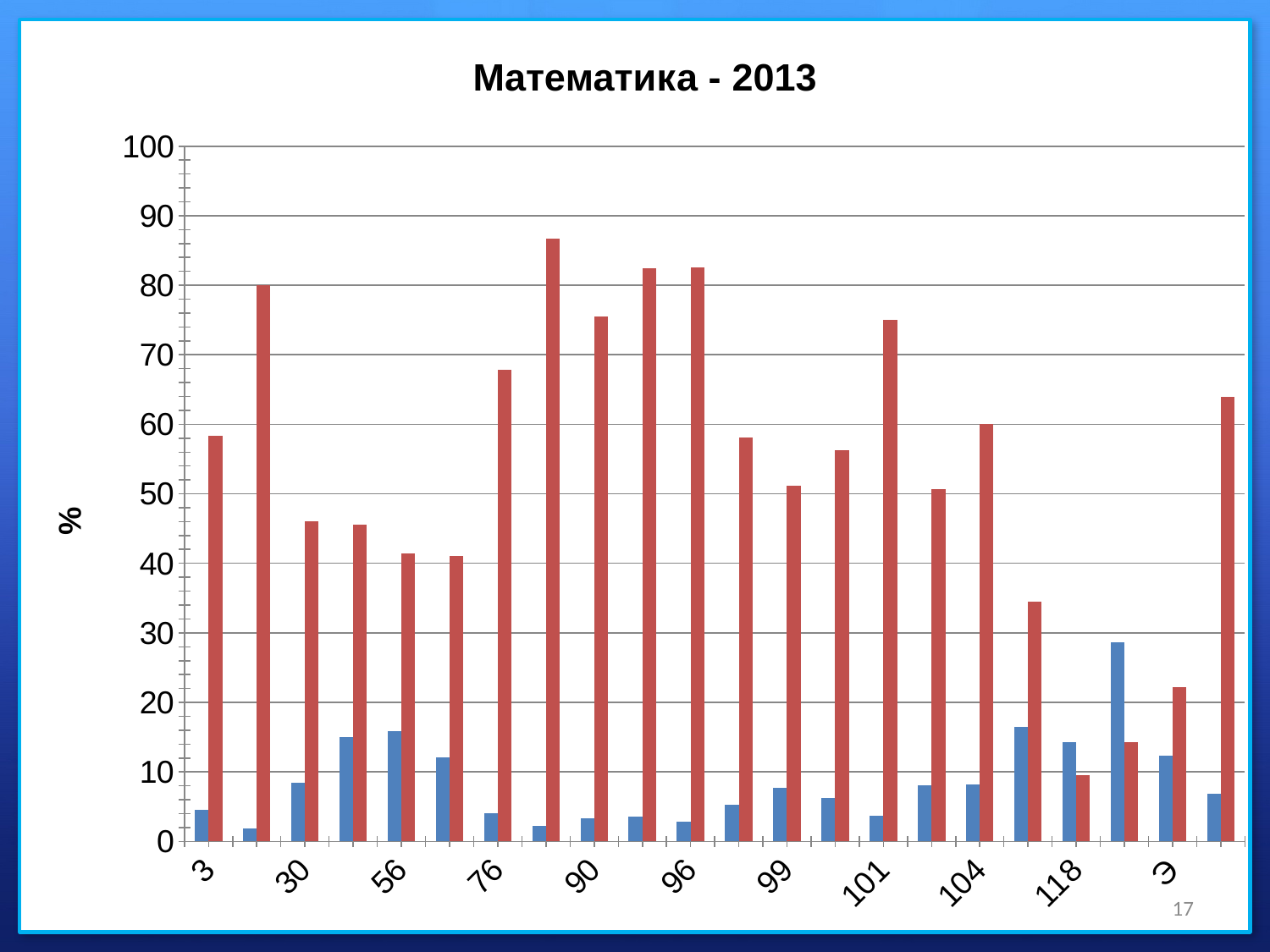
Is the red bar for category 3 greater or less than 50? greater Is the red bar for category 96 greater or less than 80? greater Is the red bar for category 76 greater or less than 60? greater How many groups of bars are plotted along the x axis? 22 What is the label on the vertical axis of the chart? % Which red bar is taller, the one for category 90 or the one for category 104? 90 What type of chart is shown on the slide? bar chart For category 118, which bar is taller, the blue one or the red one? blue What is the title of the chart? Математика - 2013